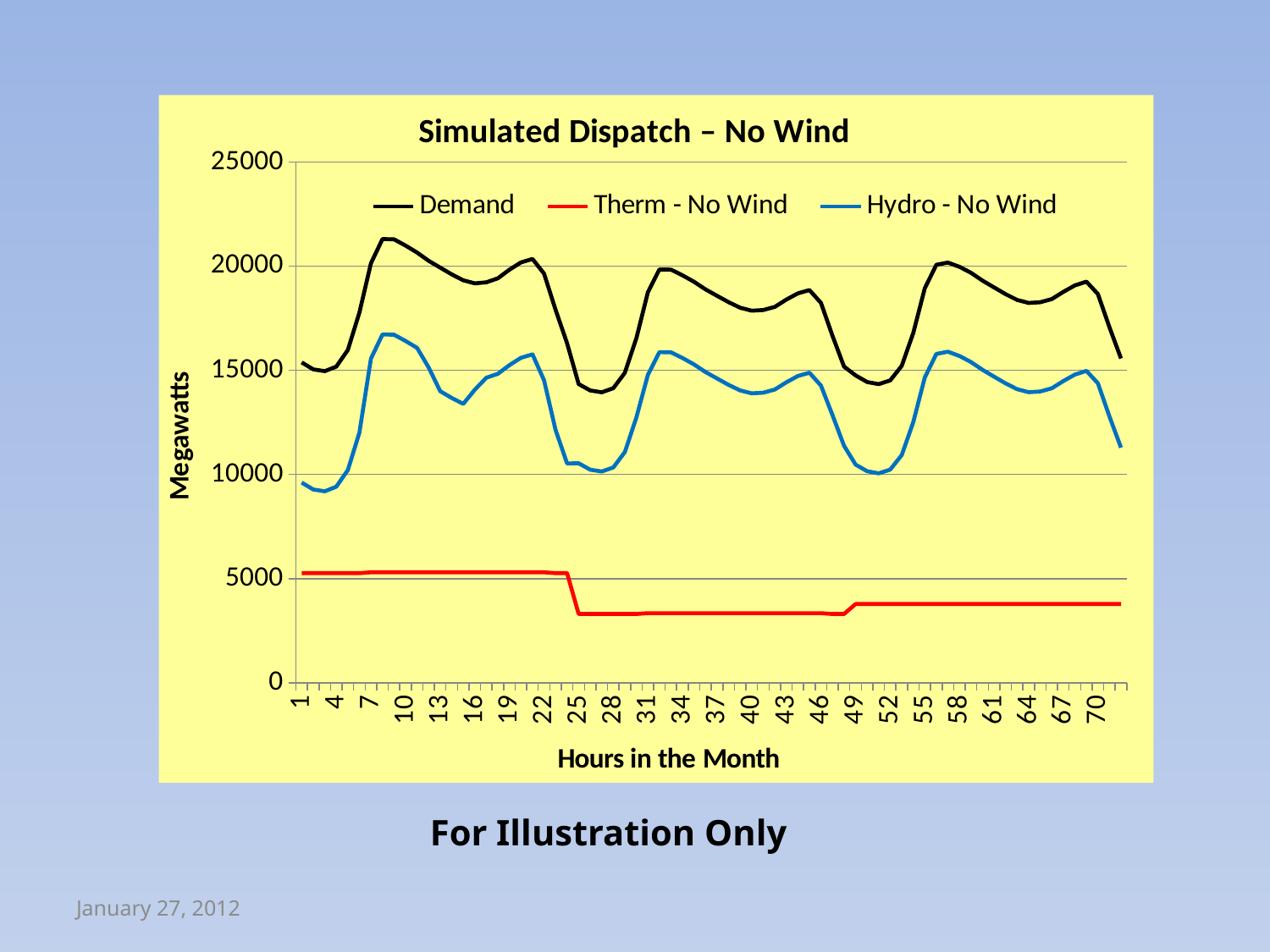
What is the label on the vertical axis of the chart? Megawatts Does the Therm - No Wind series rise or fall between hour 22 and hour 25? fall How many series does the legend of the chart list? 3 What kind of chart is shown on the slide? line chart Is the Hydro - No Wind value at hour 1 greater or less than 10000? less Which series has the lowest values across the whole chart? Therm - No Wind What is the title of the chart? Simulated Dispatch – No Wind Is the Demand value at hour 25 greater or less than 15000? less At hour 28, which is larger: Therm - No Wind or Hydro - No Wind? Hydro - No Wind Is the Hydro - No Wind value at hour 49 greater or less than 15000? less